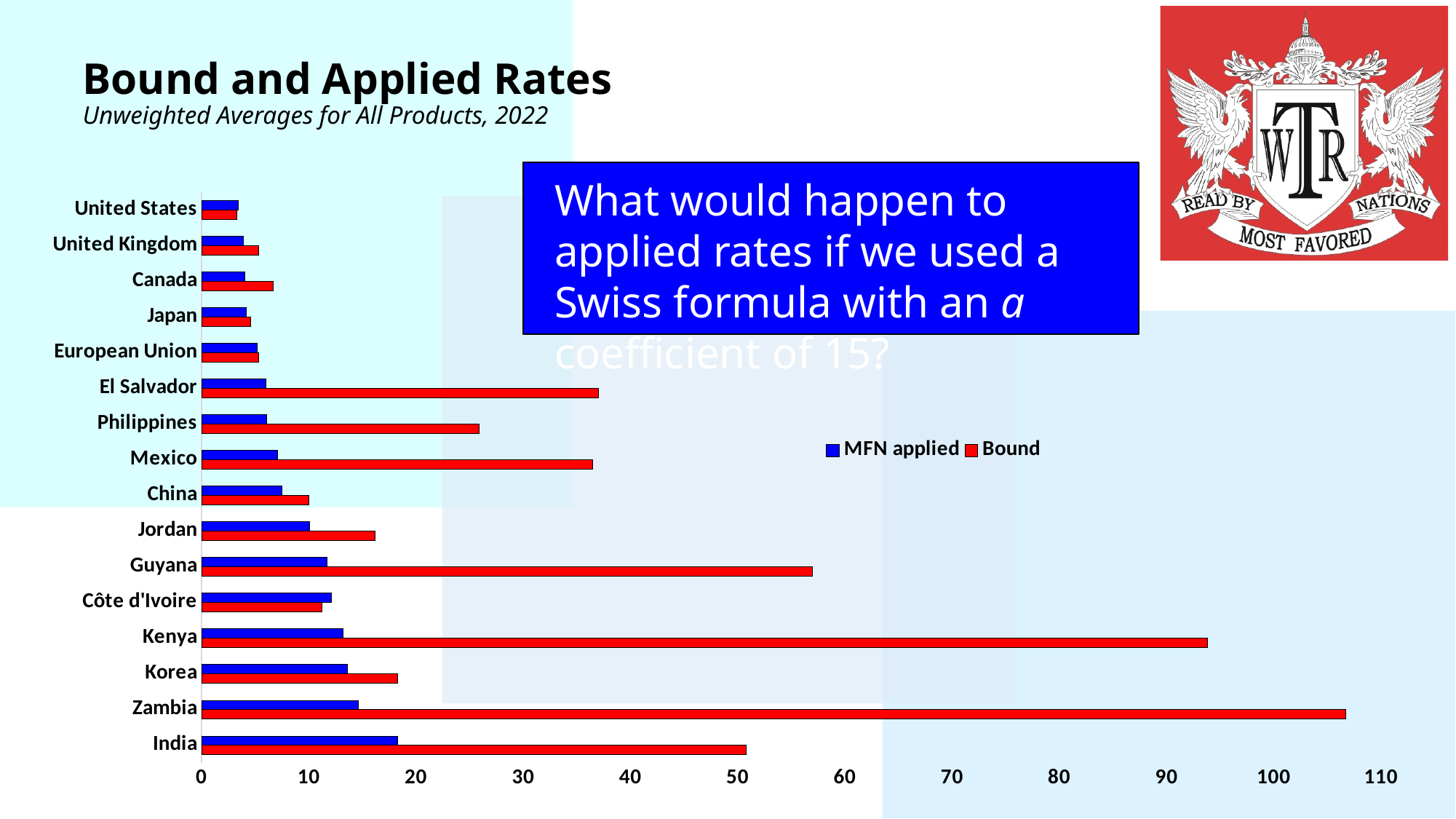
Is the Bound value for Guyana greater or less than 50? greater Is the Bound value for Zambia greater or less than 100? greater How many series does the chart legend list? 2 How many countries or regions are shown on the chart's vertical axis? 16 Which is larger, the Bound rate for El Salvador or the Bound rate for Philippines? El Salvador Is the Bound value for Philippines greater or less than 30? less Which country has the highest Bound rate on the chart? Zambia What are the two series named in the chart legend? MFN applied and Bound Which is larger, the Bound rate for Kenya or the Bound rate for Guyana? Kenya What kind of chart is shown on the slide? bar chart Which country has the highest MFN applied rate on the chart? India